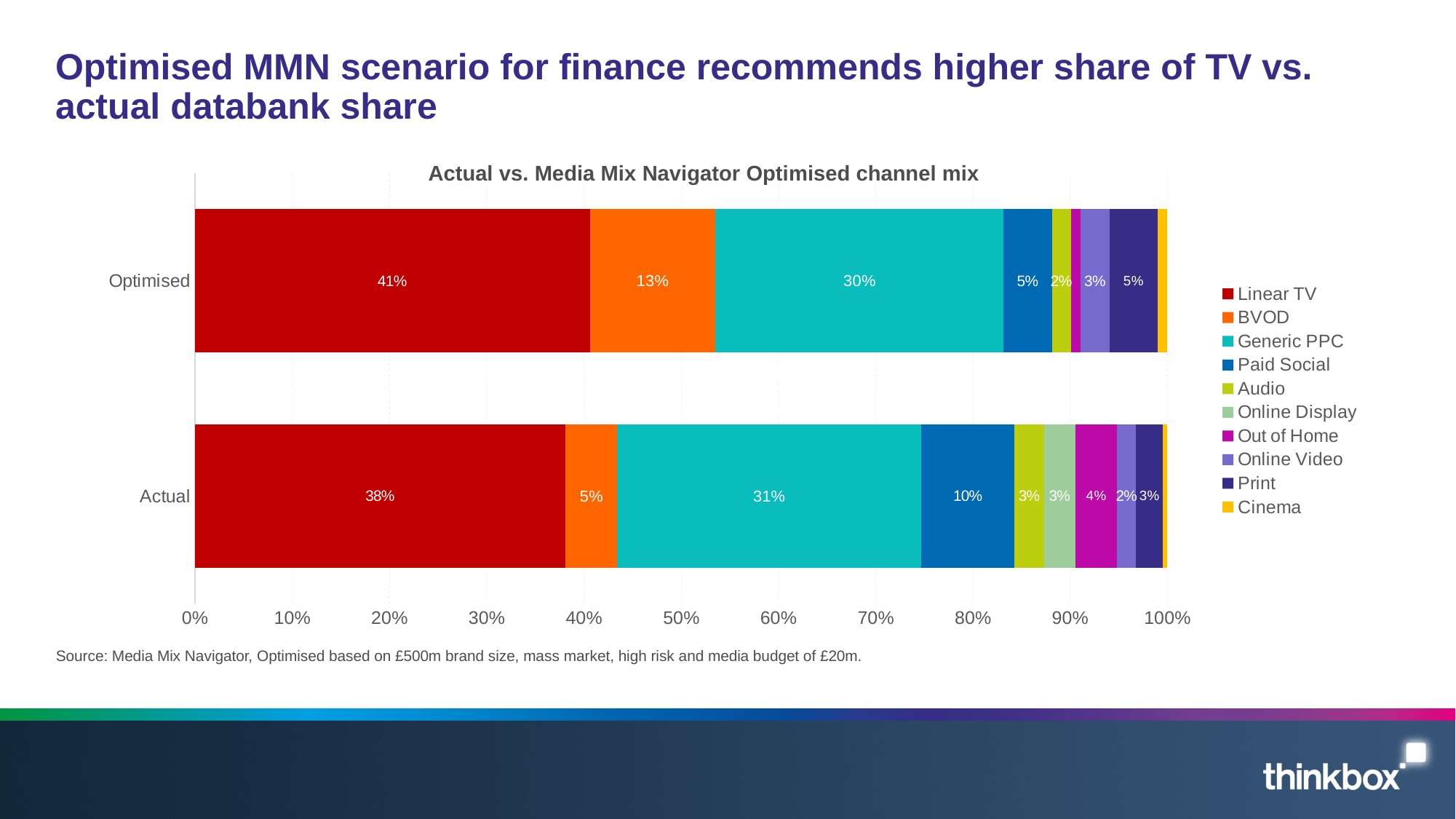
What is the Paid Social share in the Actual bar? 10% By how many percentage points does the Linear TV share in the Optimised bar exceed the Linear TV share in the Actual bar? 3 percentage points Which channel has the largest share in the Optimised bar? Linear TV Which bar has the larger BVOD share, Optimised or Actual? Optimised How many series does the legend list? 10 What is the Linear TV share in the Optimised bar? 41% What is the Generic PPC share in the Actual bar? 31% What is the BVOD share in the Optimised bar? 13% What is the title of the chart? Actual vs. Media Mix Navigator Optimised channel mix What type of chart is shown on the slide? Stacked bar chart What is the Linear TV share in the Actual bar? 38% How many bars are plotted in the chart? 2